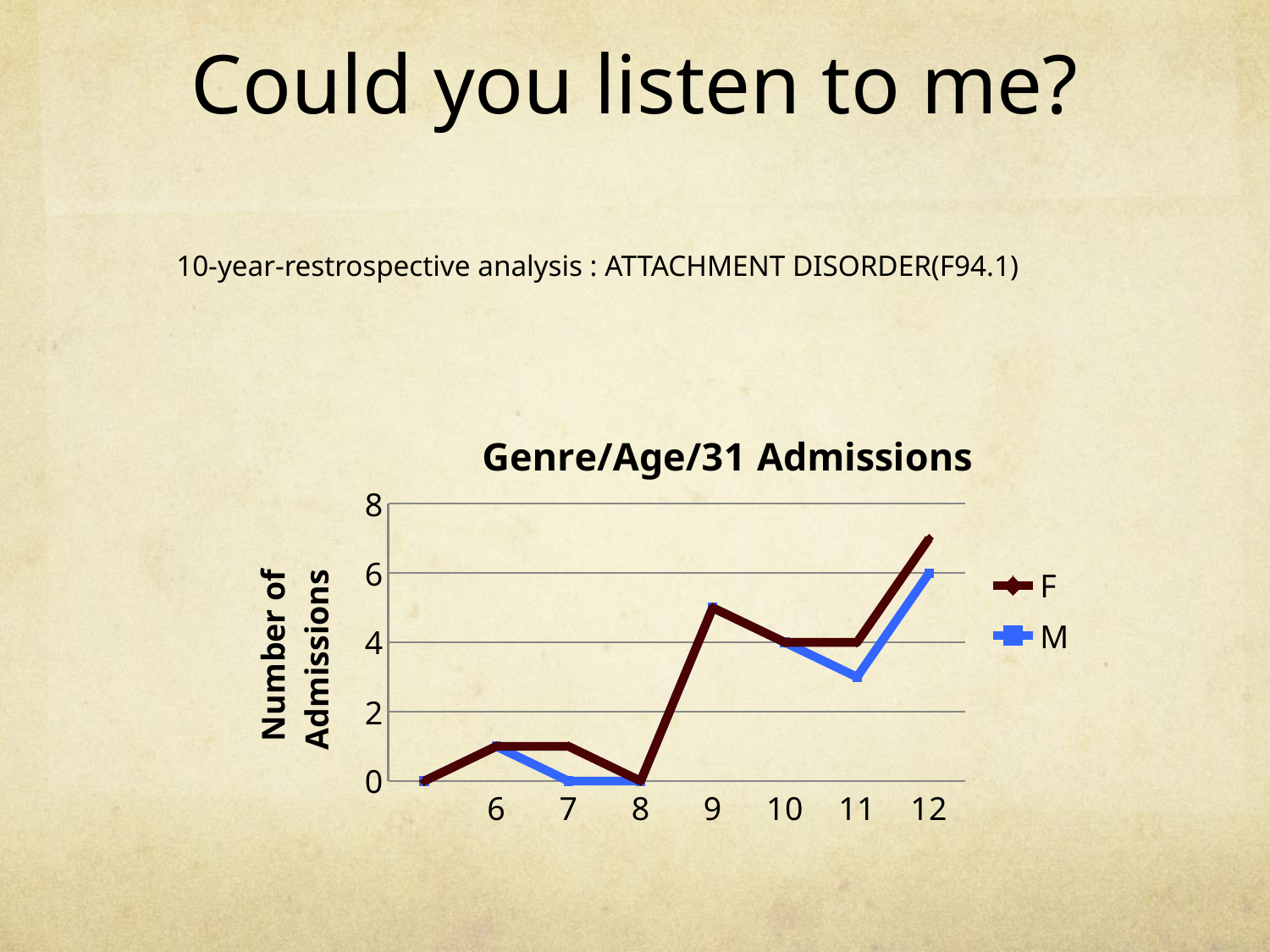
What is the number of admissions for M at age 12? 6 What kind of chart is shown on the slide? line chart What is the number of admissions for M at age 7? 0 Is the value for M at age 11 greater or less than 4? less Do the values for both series rise or fall between age 8 and age 9? rise What is the number of admissions for F at age 10? 4 At age 11, which series has the higher number of admissions, F or M? F How many series does the legend list? 2 What are the two series named in the legend? F and M What is the title of the chart? Genre/Age/31 Admissions At which age does the F series reach its highest value? 12 Is the value for F at age 12 greater or less than 6? greater